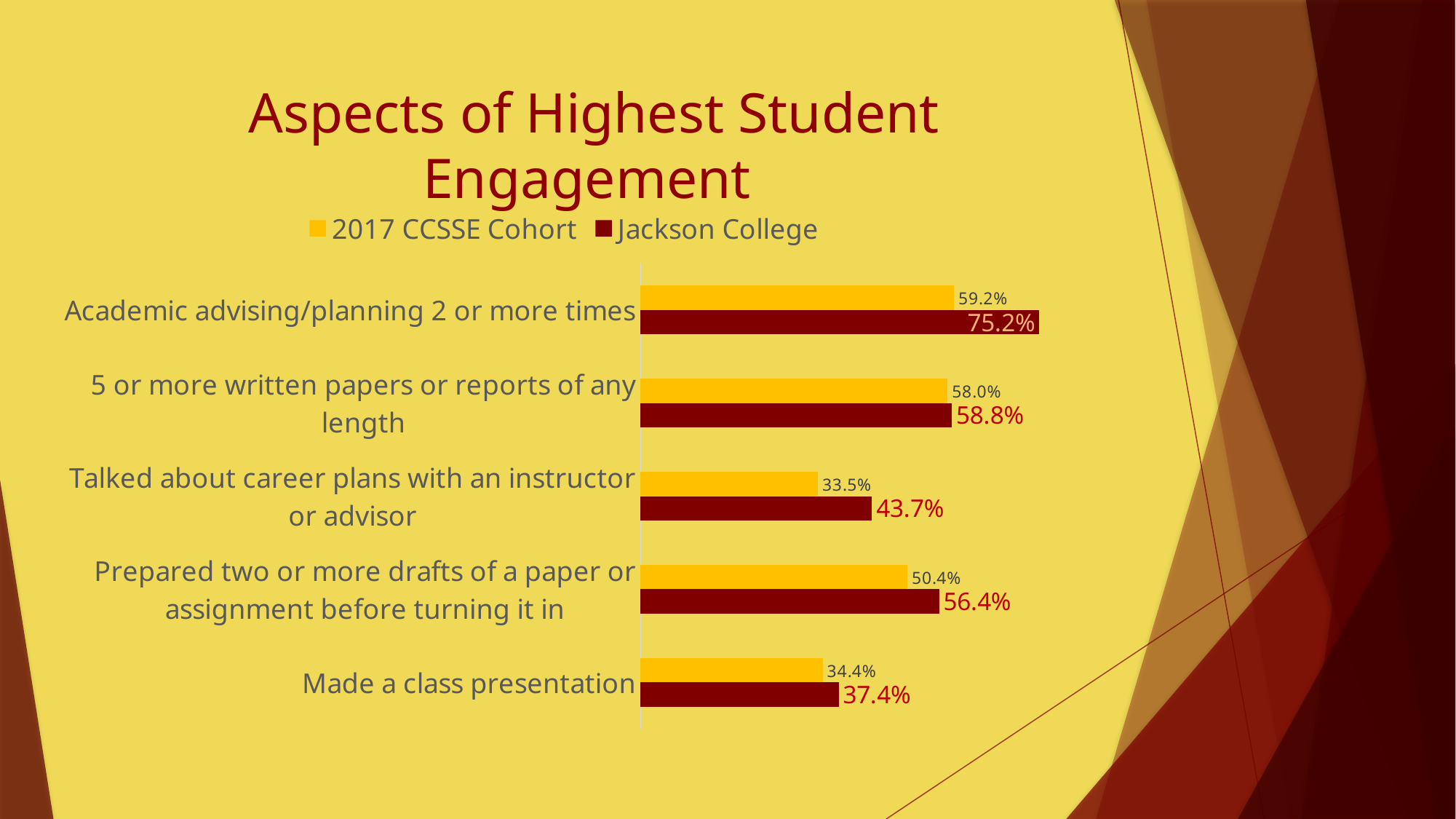
Which category has the highest Jackson College value? Academic advising/planning 2 or more times What is the Jackson College value for "Made a class presentation"? 37.4% What is the 2017 CCSSE Cohort value for "Talked about career plans with an instructor or advisor"? 33.5% What is the 2017 CCSSE Cohort value for "Prepared two or more drafts of a paper or assignment before turning it in"? 50.4% Which category has the lowest 2017 CCSSE Cohort value? Talked about career plans with an instructor or advisor What is the Jackson College value for "Academic advising/planning 2 or more times"? 75.2% How many series does the legend list? 2 How many categories are shown in the chart? 5 For "Prepared two or more drafts of a paper or assignment before turning it in", which is larger: the Jackson College value or the 2017 CCSSE Cohort value? Jackson College What is the difference between the Jackson College and 2017 CCSSE Cohort values for "Talked about career plans with an instructor or advisor"? 10.2% What kind of chart is shown on the slide? Bar chart What is the difference between the Jackson College and 2017 CCSSE Cohort values for "Academic advising/planning 2 or more times"? 16.0%